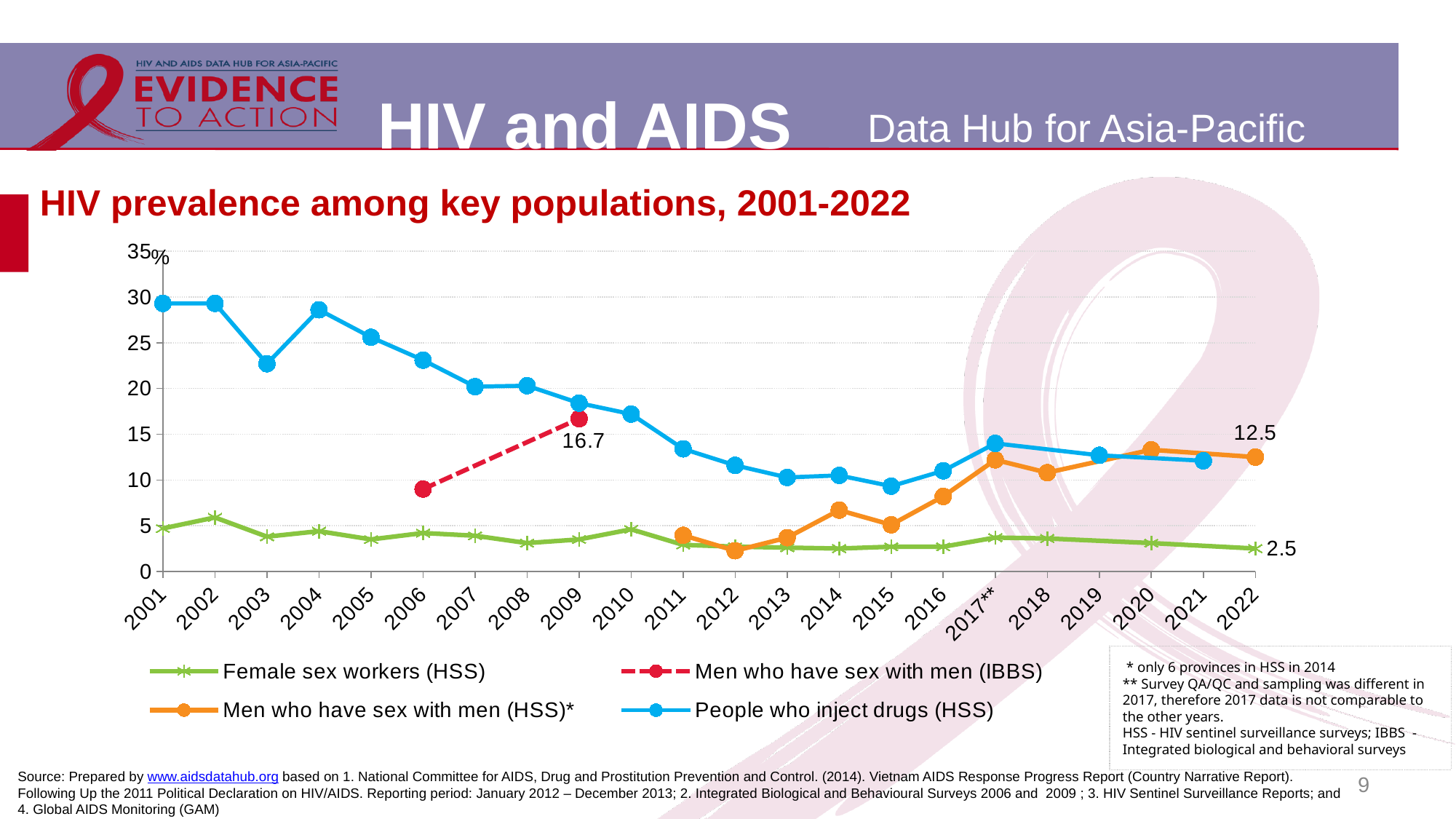
Which is larger: the value for people who inject drugs (HSS) in 2001 or in 2010? 2001 What is the difference between the 2022 values for men who have sex with men (HSS) and female sex workers (HSS)? 10 What is the HIV prevalence among female sex workers (HSS) in 2022? 2.5 What is the HIV prevalence among men who have sex with men (HSS) in 2022? 12.5 How many years are shown on the x axis? 22 How many series does the legend list? 4 Is the value for men who have sex with men (HSS) in 2012 greater or less than 5? less What is the title of the chart? HIV prevalence among key populations, 2001-2022 Is the value for people who inject drugs (HSS) in 2001 greater or less than 25? greater What is the HIV prevalence among men who have sex with men (IBBS) in 2009? 16.7 What type of chart is shown on the slide? line chart Do the values for people who inject drugs (HSS) generally rise or fall from 2001 to 2015? fall